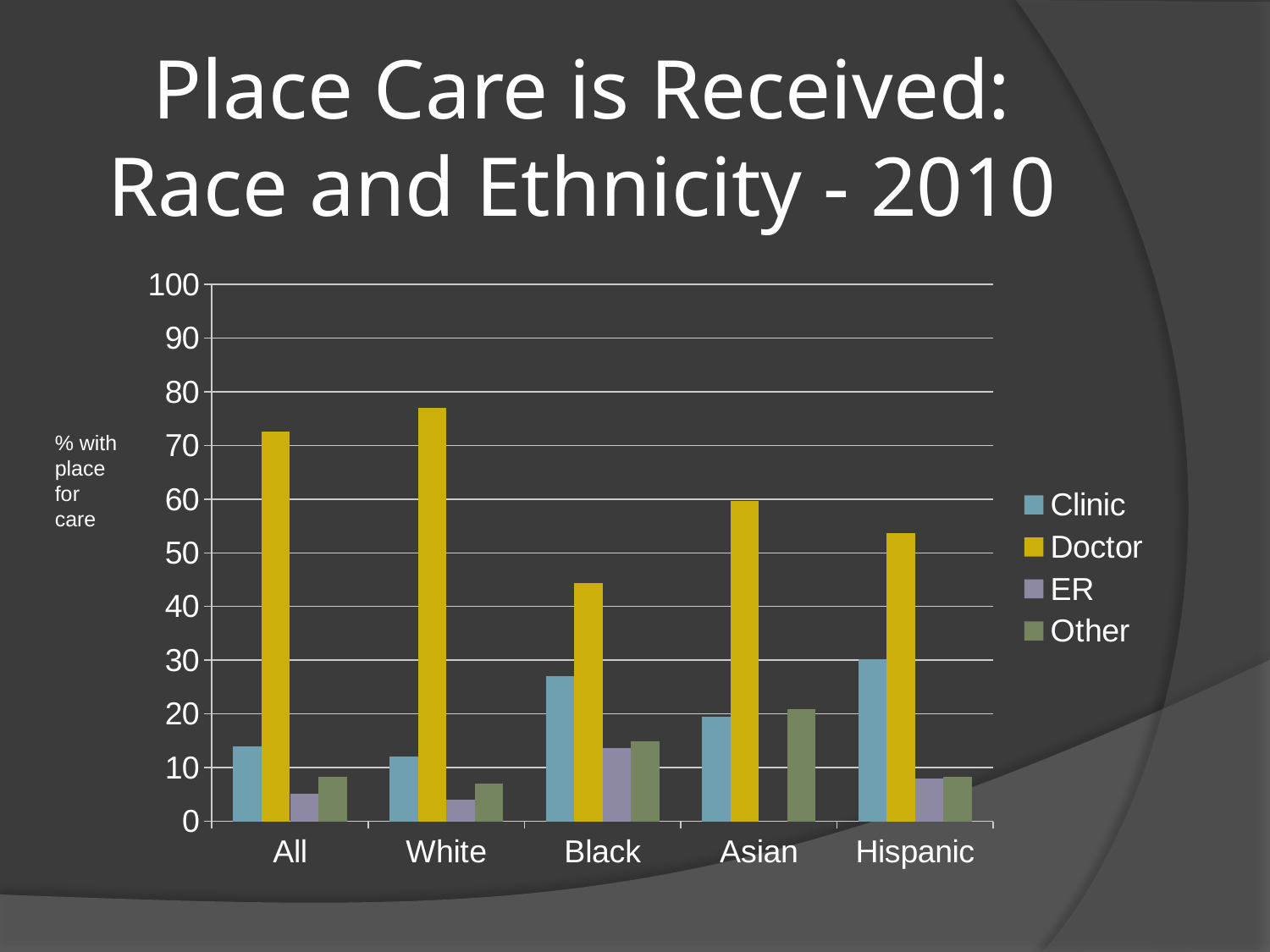
Which category has the highest Clinic value? Hispanic Which category has the highest Doctor value? White Is the Clinic value for Hispanic greater or less than 20? greater What colour represents the Doctor series in the legend? Yellow Is the Doctor value for Black greater or less than 50? less Which is larger, the Clinic value for Black or the Clinic value for White? Black Which category has the lowest Doctor value? Black How many series does the legend list? 4 What is the label on the vertical axis? % with place for care How many race/ethnicity categories are shown on the x axis? 5 Which is larger, the Other value for Asian or the Other value for Hispanic? Asian What kind of chart is shown on the slide? Bar chart